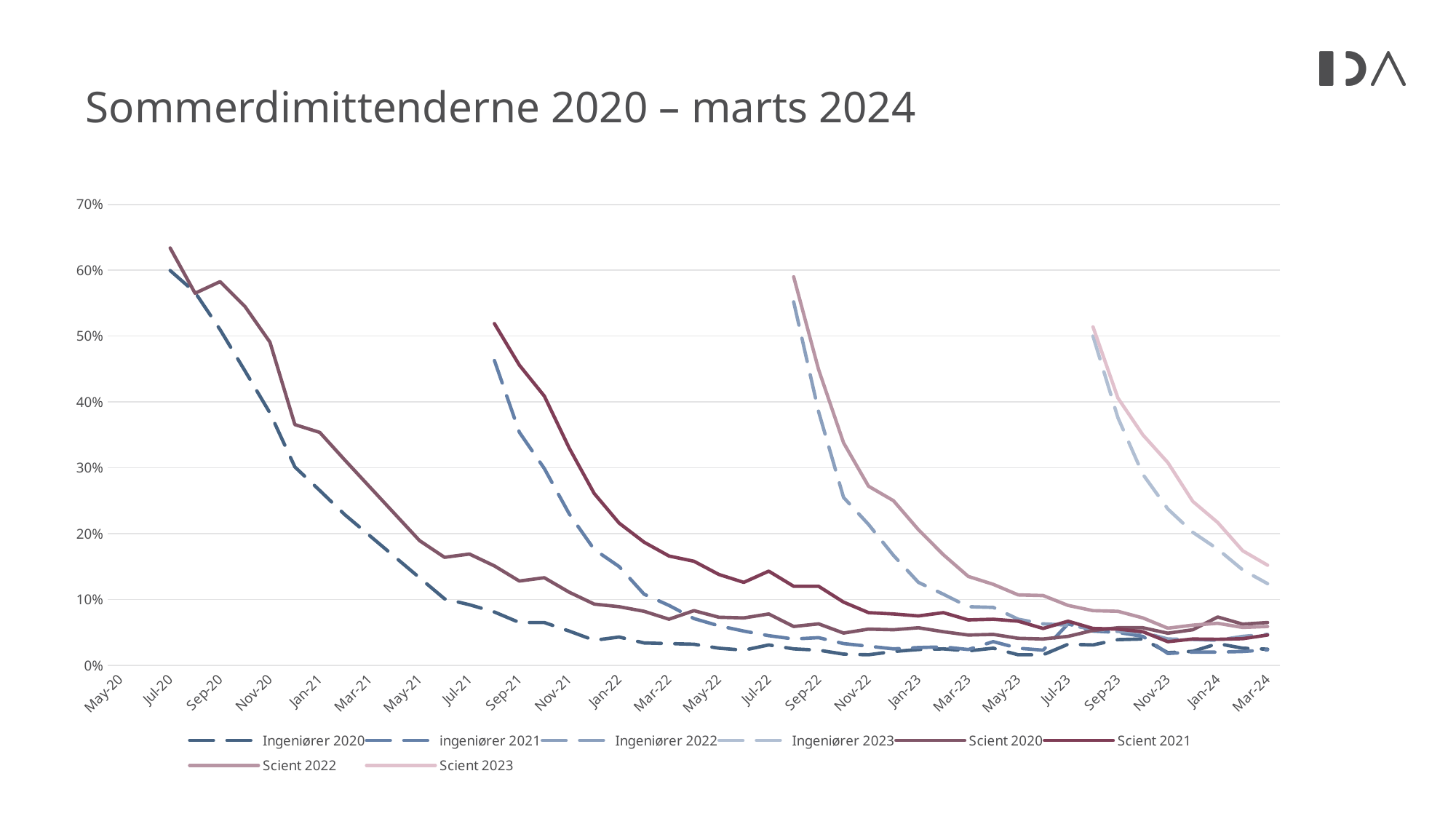
Is the value for Scient 2021 at its first point (around Aug-21) greater or less than 40%? greater Which series reaches the highest value on the chart? Scient 2020 How many series does the legend list? 8 At Mar-24, which is larger: Scient 2023 or Ingeniører 2023? Scient 2023 What kind of chart is shown on the slide? Line chart Do the values of each series rise or fall over time along the x axis? Fall Is the value for Ingeniører 2020 at Mar-24 greater or less than 10%? less Is the value for Scient 2022 at its first point (around Aug-22) greater or less than 50%? greater Are the Ingeniører series drawn with dashed or solid lines? Dashed How many labels are shown on the x axis? 24 What is the title of the chart? Sommerdimittenderne 2020 – marts 2024